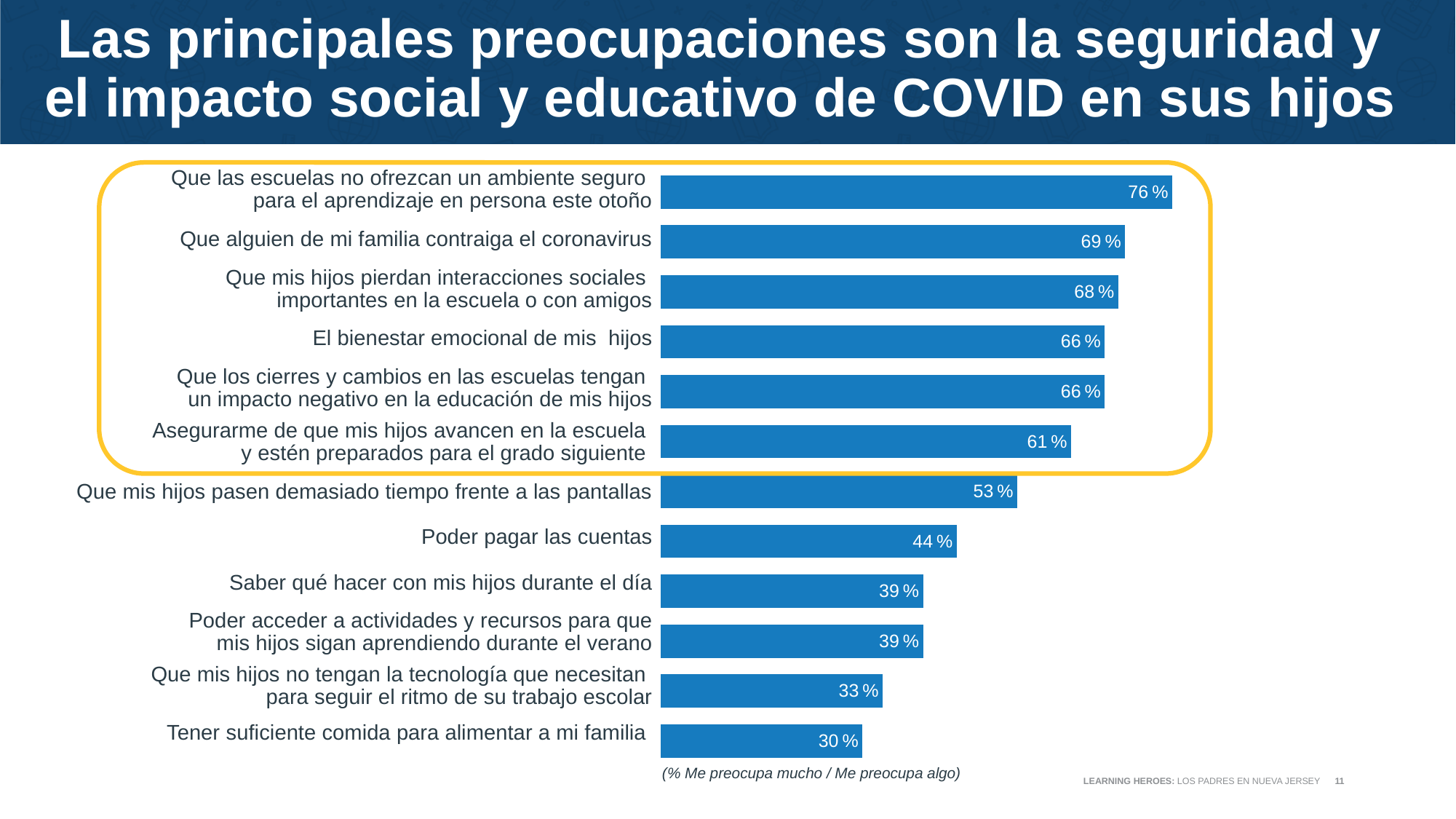
What is the difference between the value for "El bienestar emocional de mis hijos" and the value for "Asegurarme de que mis hijos avancen en la escuela y estén preparados para el grado siguiente"? 5 percentage points Which has a larger value: "Que mis hijos pasen demasiado tiempo frente a las pantallas" or "Saber qué hacer con mis hijos durante el día"? Que mis hijos pasen demasiado tiempo frente a las pantallas Which concern has the highest percentage? Que las escuelas no ofrezcan un ambiente seguro para el aprendizaje en persona este otoño What is the value for "Que mis hijos pasen demasiado tiempo frente a las pantallas"? 53 % How many concerns (bars) are shown in the chart? 12 What is the value for "Que mis hijos no tengan la tecnología que necesitan para seguir el ritmo de su trabajo escolar"? 33 % What is the value for "Poder pagar las cuentas"? 44 % What is the difference between the value for "Que alguien de mi familia contraiga el coronavirus" and the value for "Tener suficiente comida para alimentar a mi familia"? 39 percentage points What percentage of parents are worried that schools will not offer a safe environment for in-person learning this fall ("Que las escuelas no ofrezcan un ambiente seguro para el aprendizaje en persona este otoño")? 76 % Which concern has the lowest percentage? Tener suficiente comida para alimentar a mi familia What kind of chart is shown on the slide? Bar chart How many concerns are enclosed in the yellow outlined box? 6